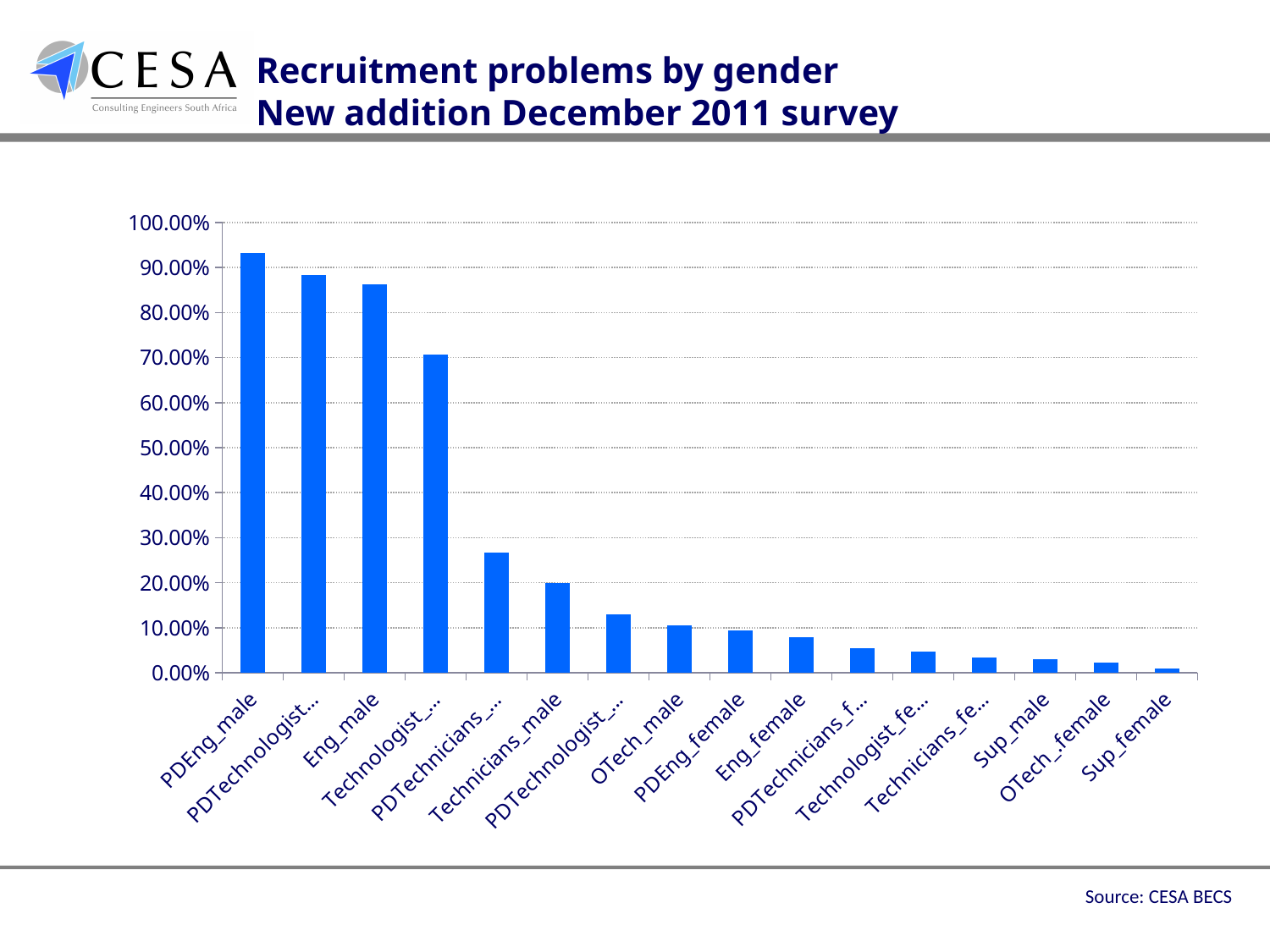
Which category has the lowest value? Sup_female Is the value for Eng_male greater or less than 80.00%? greater Is the value for Technicians_male greater or less than 30.00%? less Do the values rise or fall from left to right along the x axis? fall Which category has the highest value? PDEng_male What kind of chart is shown on the slide? bar chart What is the title of the slide? Recruitment problems by gender New addition December 2011 survey Is the value for Eng_female greater or less than 10.00%? less Which is larger, the value for Eng_male or the value for Eng_female? Eng_male How many categories are plotted on the x axis? 16 Which is larger, the value for OTech_male or the value for Sup_male? OTech_male